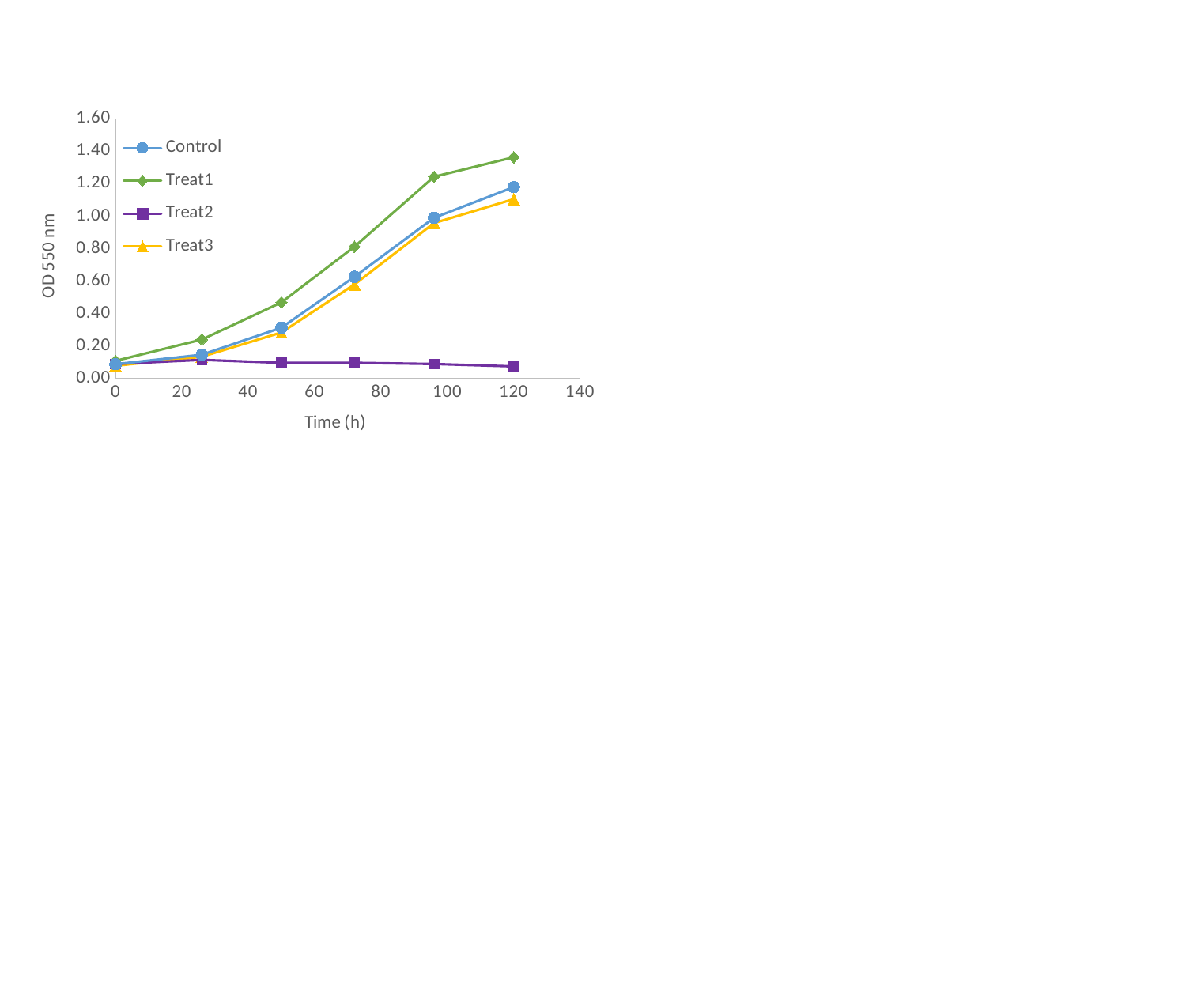
Is the value for Treat2 at 120 h greater or less than 0.20? less How many series does the legend list? 4 What kind of chart is shown on the slide? Line chart Is the value for Control at about 50 h greater or less than 0.40? less Which series has the highest OD 550 nm value at 120 h? Treat1 Which series has the lowest OD 550 nm value at 120 h? Treat2 How many data points are plotted for the Control series? 6 Does the Treat1 series rise or fall as time increases along the x axis? Rises Is the value for Control at 120 h greater or less than 1.00? greater At 120 h, which is larger: the Control value or the Treat3 value? Control What is the title of the y axis? OD 550 nm